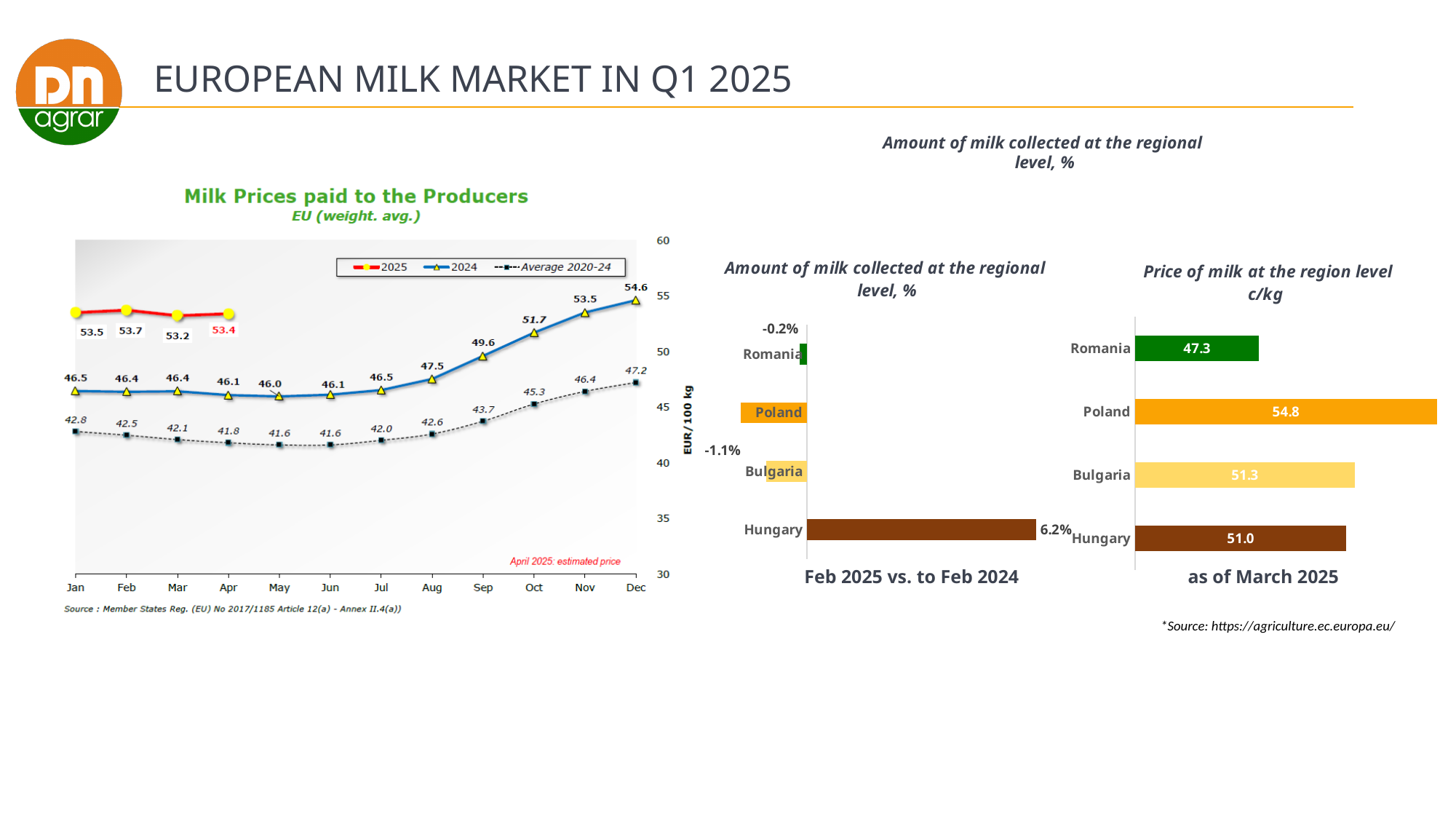
In the 'Price of milk at the region level c/kg' chart, what is the difference between Poland and Romania? 7.5 In the 'Milk Prices paid to the Producers' chart, does the 2024 series rise or fall from July to December? rise In the 'Milk Prices paid to the Producers' chart, what is the difference between the 2025 and 2024 values in January? 7.0 In the 'Milk Prices paid to the Producers' chart, what is the Average 2020-24 value for May? 41.6 In the 'Price of milk at the region level c/kg' chart, which country has the highest price? Poland In the 'Milk Prices paid to the Producers' chart, what was the 2024 value in December? 54.6 In the 'Milk Prices paid to the Producers' chart, what was the 2025 value in February? 53.7 In the 'Milk Prices paid to the Producers' chart, how many series does the legend list? 3 In the 'Amount of milk collected at the regional level, %' chart, what is the value for Hungary? 6.2% What kind of chart is 'Price of milk at the region level c/kg'? bar chart In the 'Milk Prices paid to the Producers' chart, which month has the lowest Average 2020-24 value? May and Jun (41.6) In the 'Price of milk at the region level c/kg' chart, what is the value for Romania? 47.3